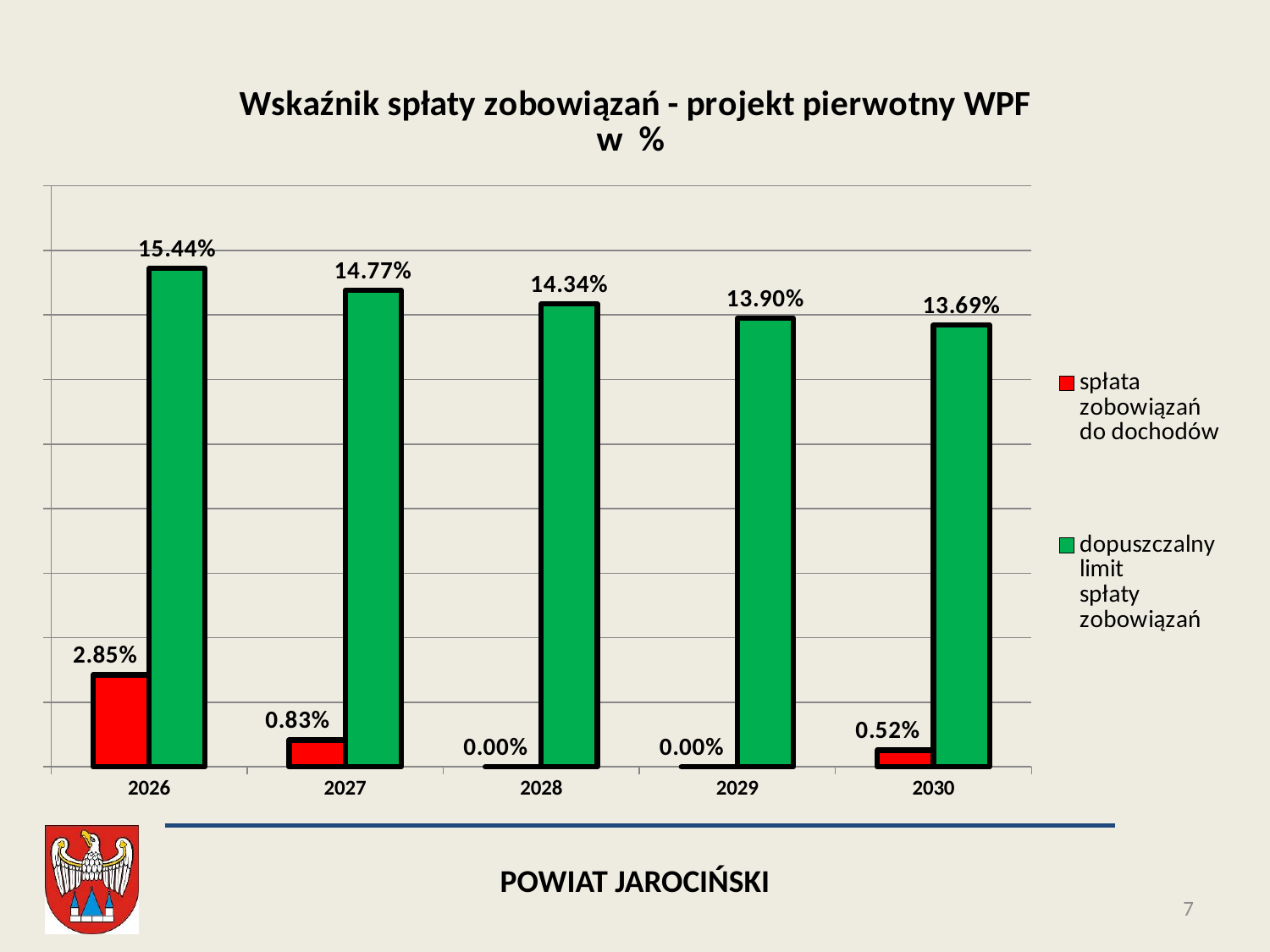
Which is larger: 'dopuszczalny limit spłaty zobowiązań' in 2027 or in 2028? 2027 In which year is 'spłata zobowiązań do dochodów' the highest? 2026 How many series does the legend list? 2 Does 'dopuszczalny limit spłaty zobowiązań' rise or fall from 2026 to 2030? fall What is the value of 'spłata zobowiązań do dochodów' for 2030? 0.52% What kind of chart is shown on the slide? bar chart What is the value of 'spłata zobowiązań do dochodów' for 2027? 0.83% In which year is 'dopuszczalny limit spłaty zobowiązań' the lowest? 2030 What is the difference between 'dopuszczalny limit spłaty zobowiązań' and 'spłata zobowiązań do dochodów' in 2026? 12.59% What is the value of 'dopuszczalny limit spłaty zobowiązań' for 2029? 13.90% What is the value of 'dopuszczalny limit spłaty zobowiązań' for 2026? 15.44% How many years are shown on the x axis? 5